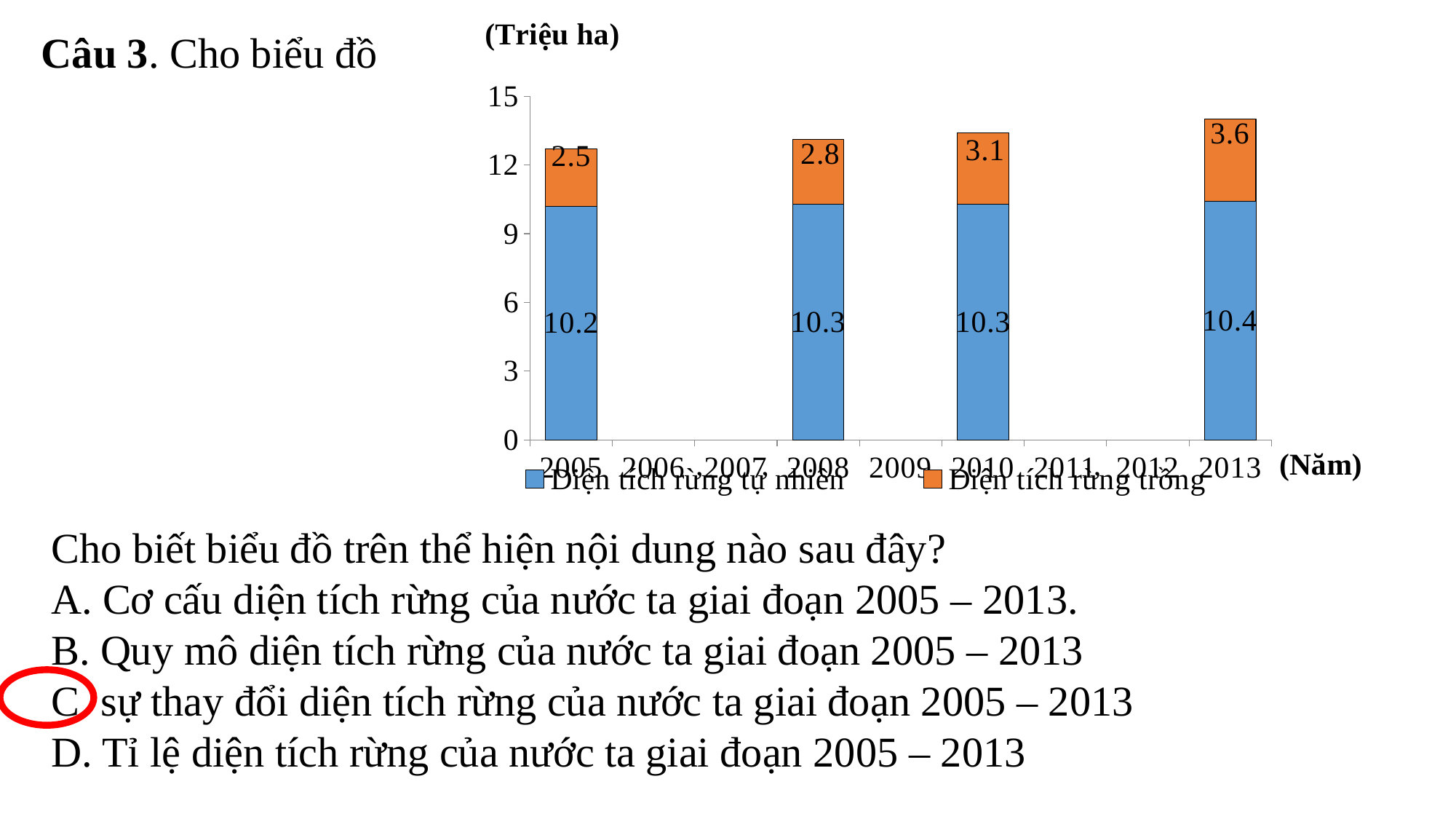
What is the total height of the stacked bar for 2013? 14 What is the value of Diện tích rừng tự nhiên in 2005? 10.2 In which year is Diện tích rừng trồng the lowest? 2005 How many years have bars plotted in the chart? 4 How many series does the legend list? 2 What is the difference between Diện tích rừng trồng in 2013 and in 2005? 1.1 What is the total height of the stacked bar for 2010? 13.4 In which year is Diện tích rừng trồng the highest? 2013 What is the value of Diện tích rừng trồng in 2013? 3.6 What is the value of Diện tích rừng trồng in 2008? 2.8 Which is larger: Diện tích rừng trồng in 2010 or in 2008? 2010 Does Diện tích rừng trồng rise or fall from 2005 to 2013? rise